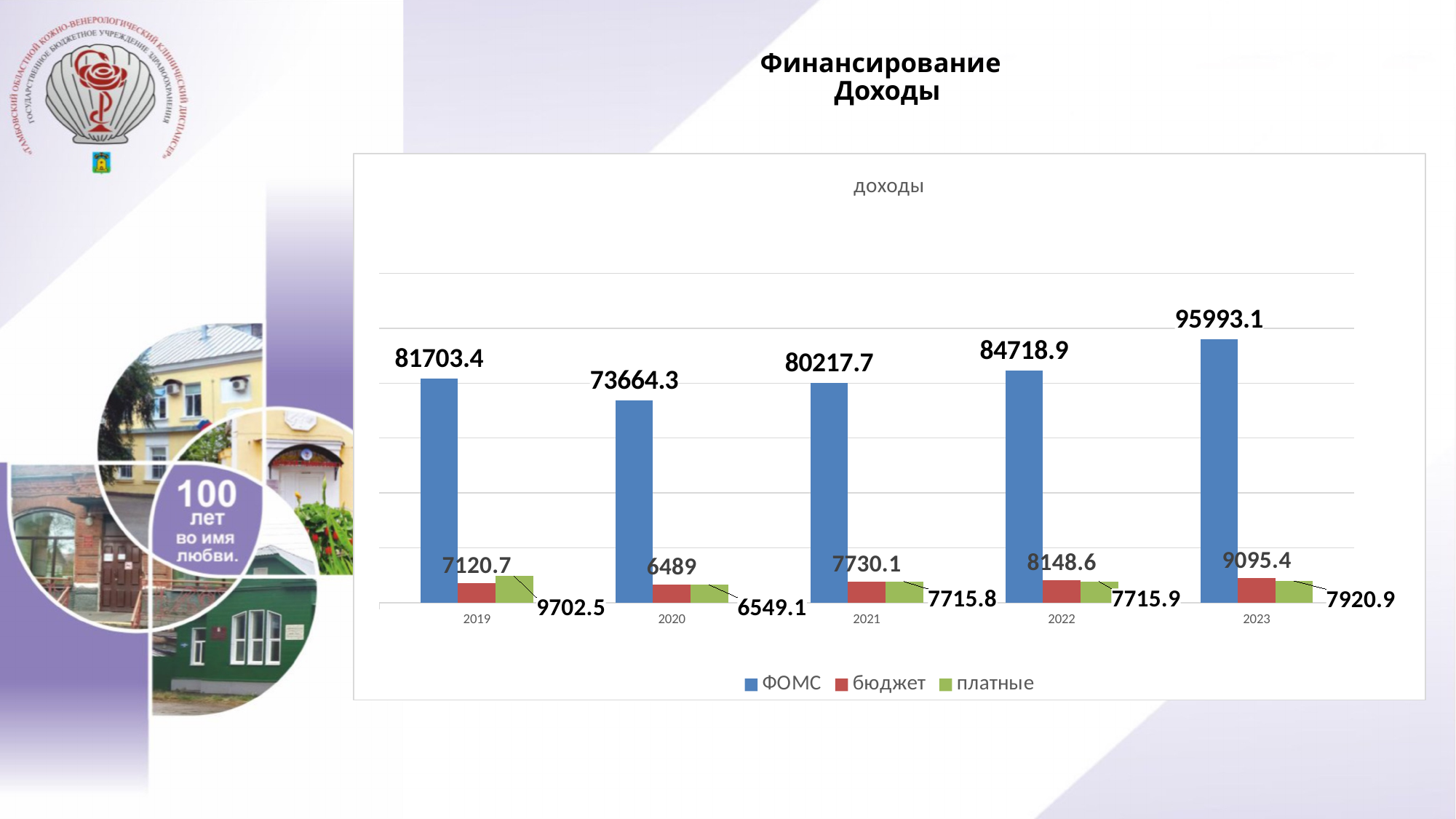
In which year is the ФОМС value the lowest? 2020 What is the value for бюджет in 2020? 6489 What is the value for ФОМС in 2023? 95993.1 What kind of chart is shown? bar chart What is the difference between the ФОМС values for 2023 and 2022? 11274.2 Which is larger in 2019: бюджет or платные? платные In which year is the платные value the lowest? 2020 How many years are shown on the x axis? 5 Does the бюджет value rise or fall from 2020 to 2023? rise What is the value for платные in 2019? 9702.5 In which year is the ФОМС value the highest? 2023 How many series does the legend list? 3